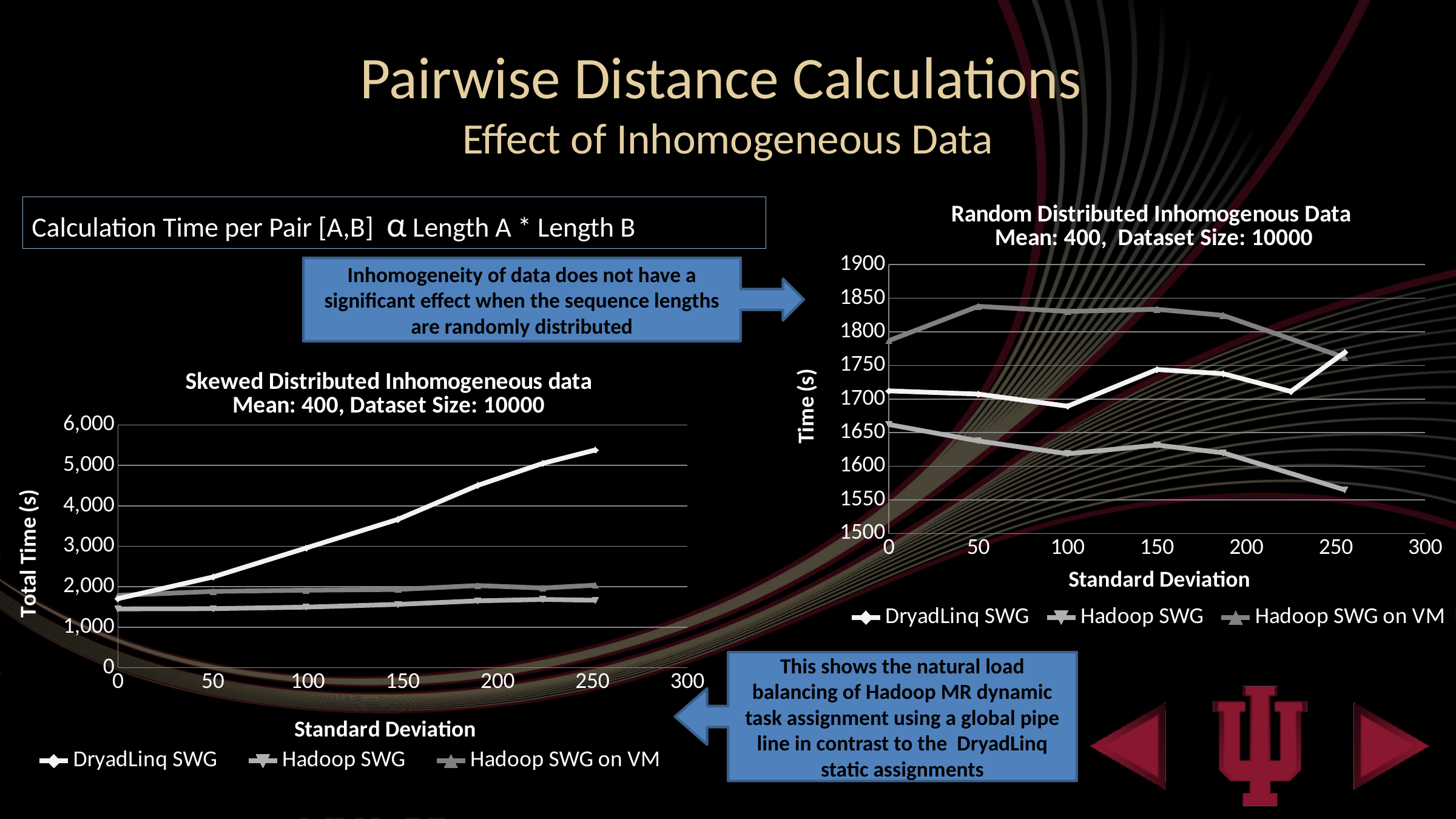
In the 'Skewed Distributed Inhomogeneous data' chart, is the DryadLinq SWG value at standard deviation 0 greater or less than 2,000? less In the 'Skewed Distributed Inhomogeneous data' chart, is the DryadLinq SWG value at standard deviation 250 larger or smaller than its value at standard deviation 0? larger What is the x-axis label of the 'Skewed Distributed Inhomogeneous data' chart? Standard Deviation In the 'Random Distributed Inhomogenous Data' chart, is the DryadLinq SWG value at standard deviation 100 greater or less than 1700? less In the 'Skewed Distributed Inhomogeneous data' chart, which series has the highest value at standard deviation 250? DryadLinq SWG In the 'Skewed Distributed Inhomogeneous data' chart, is the DryadLinq SWG value at standard deviation 150 greater or less than 3,000? greater In the 'Skewed Distributed Inhomogeneous data' chart, does the DryadLinq SWG line rise or fall as standard deviation increases? rises What kind of chart is the 'Skewed Distributed Inhomogeneous data' chart on the left? line chart What is the y-axis label of the 'Random Distributed Inhomogenous Data' chart? Time (s) How many series does the legend of the 'Random Distributed Inhomogenous Data' chart list? 3